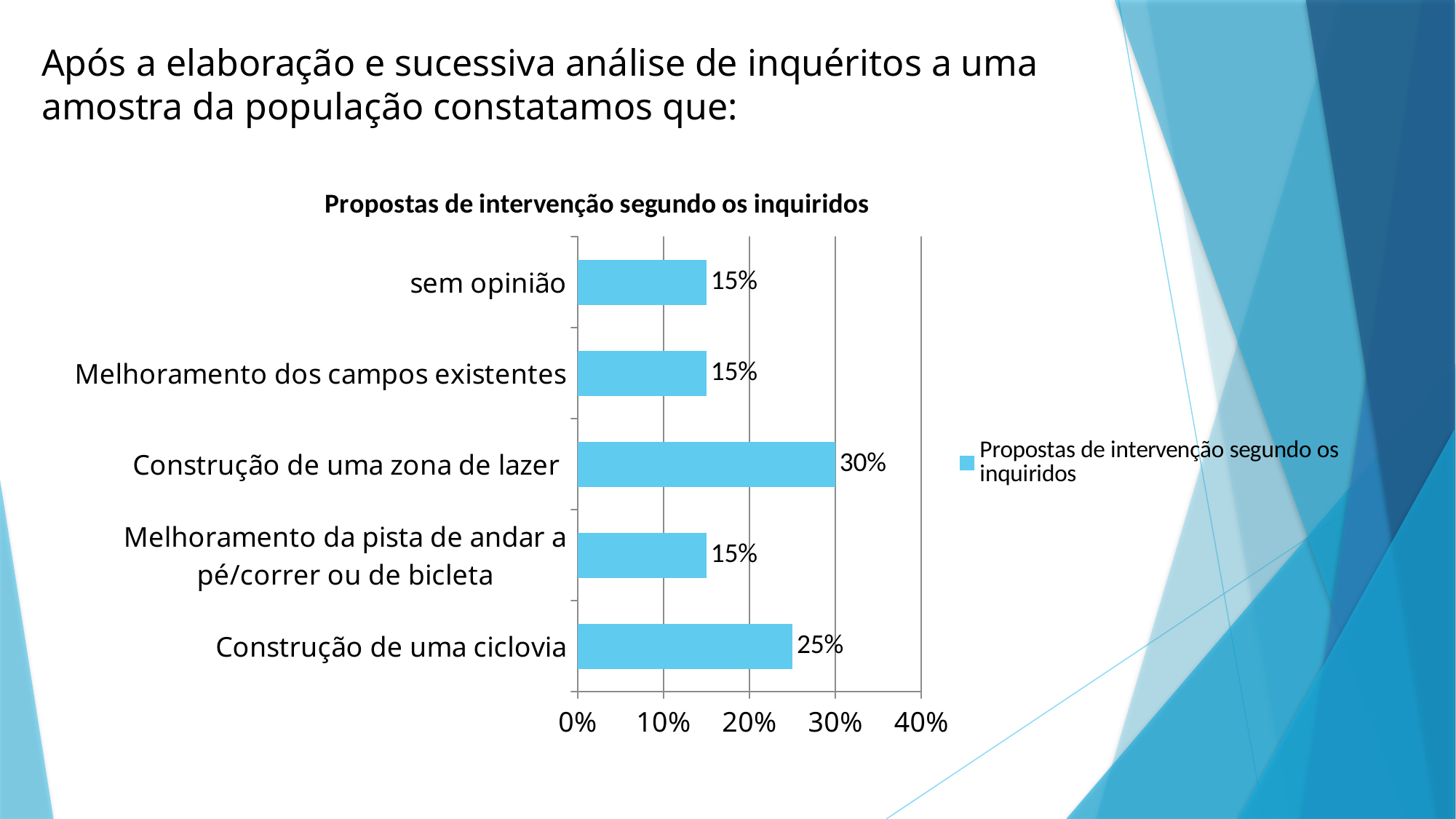
How many categories are shown in the chart? 5 Which category has the highest value? Construção de uma zona de lazer What is the difference between the values for "Construção de uma ciclovia" and "sem opinião"? 10% What is the difference between the values for "Construção de uma zona de lazer" and "Construção de uma ciclovia"? 5% Which is larger: the value for "Construção de uma ciclovia" or the value for "Melhoramento da pista de andar a pé/correr ou de bicleta"? Construção de uma ciclovia What is the value for "Construção de uma ciclovia"? 25% What is the value for "sem opinião"? 15% What kind of chart is shown on the slide? bar chart What is the value for "Melhoramento dos campos existentes"? 15% What is the value for "Construção de uma zona de lazer"? 30% Is the value for "Construção de uma zona de lazer" greater or less than 20%? greater What is the title of the chart? Propostas de intervenção segundo os inquiridos